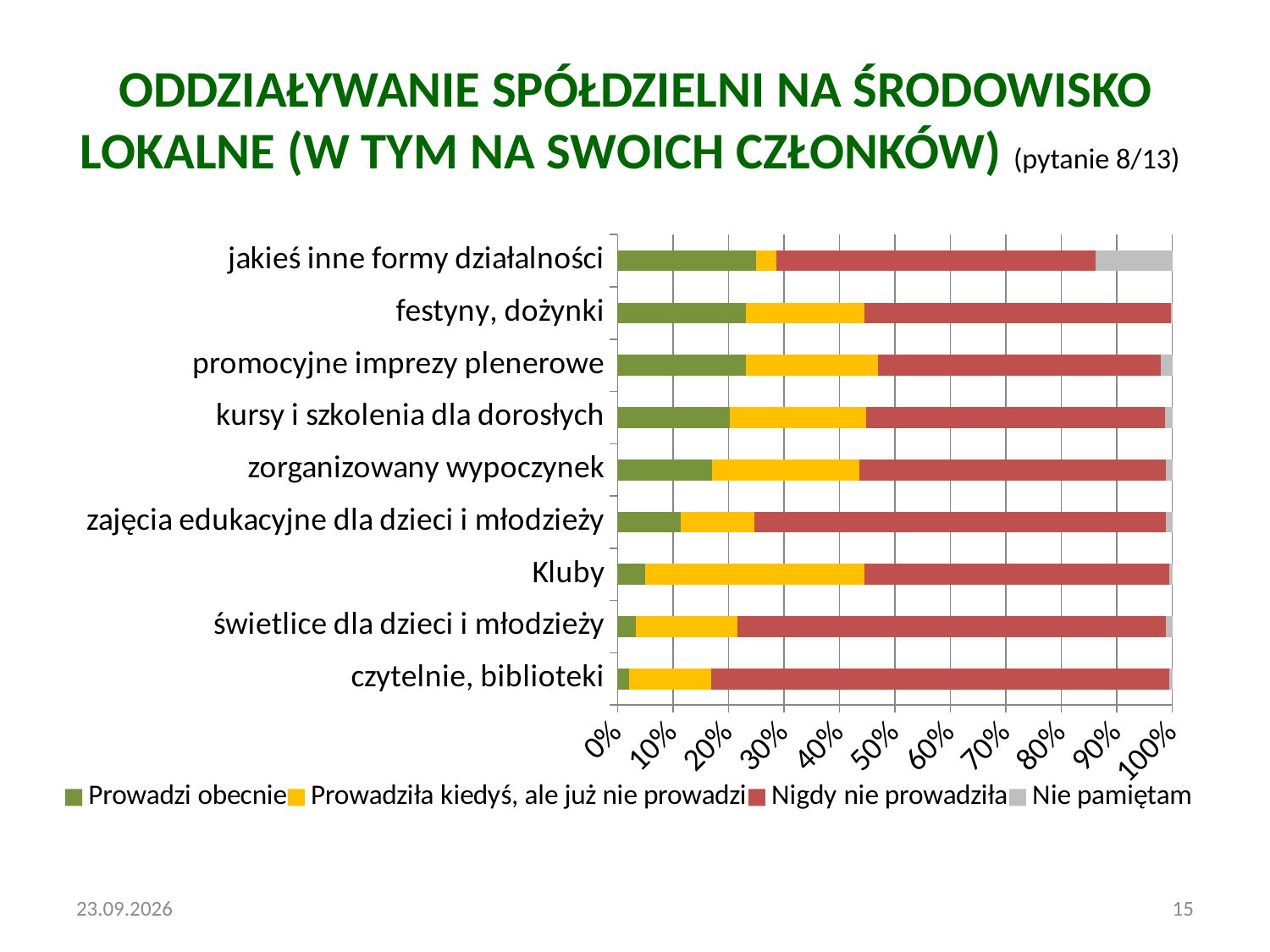
Which category has the largest 'Nie pamiętam' segment? jakieś inne formy działalności What kind of chart is shown on the slide? bar chart How many series does the legend list? 4 Is the 'Nie pamiętam' value for jakieś inne formy działalności greater or less than 10%? greater Which category has the largest 'Prowadziła kiedyś, ale już nie prowadzi' segment? Kluby Which has a larger 'Nigdy nie prowadziła' value: zajęcia edukacyjne dla dzieci i młodzieży or festyny, dożynki? zajęcia edukacyjne dla dzieci i młodzieży Is the 'Prowadzi obecnie' value for zajęcia edukacyjne dla dzieci i młodzieży greater or less than 20%? less Is the 'Prowadziła kiedyś, ale już nie prowadzi' value for Kluby greater or less than 30%? greater Which has a larger 'Prowadzi obecnie' value: Kluby or zorganizowany wypoczynek? zorganizowany wypoczynek Which category has the largest 'Nigdy nie prowadziła' segment? czytelnie, biblioteki How many categories (activity types) are plotted on the chart? 9 What colour represents the 'Nigdy nie prowadziła' series in the chart? red